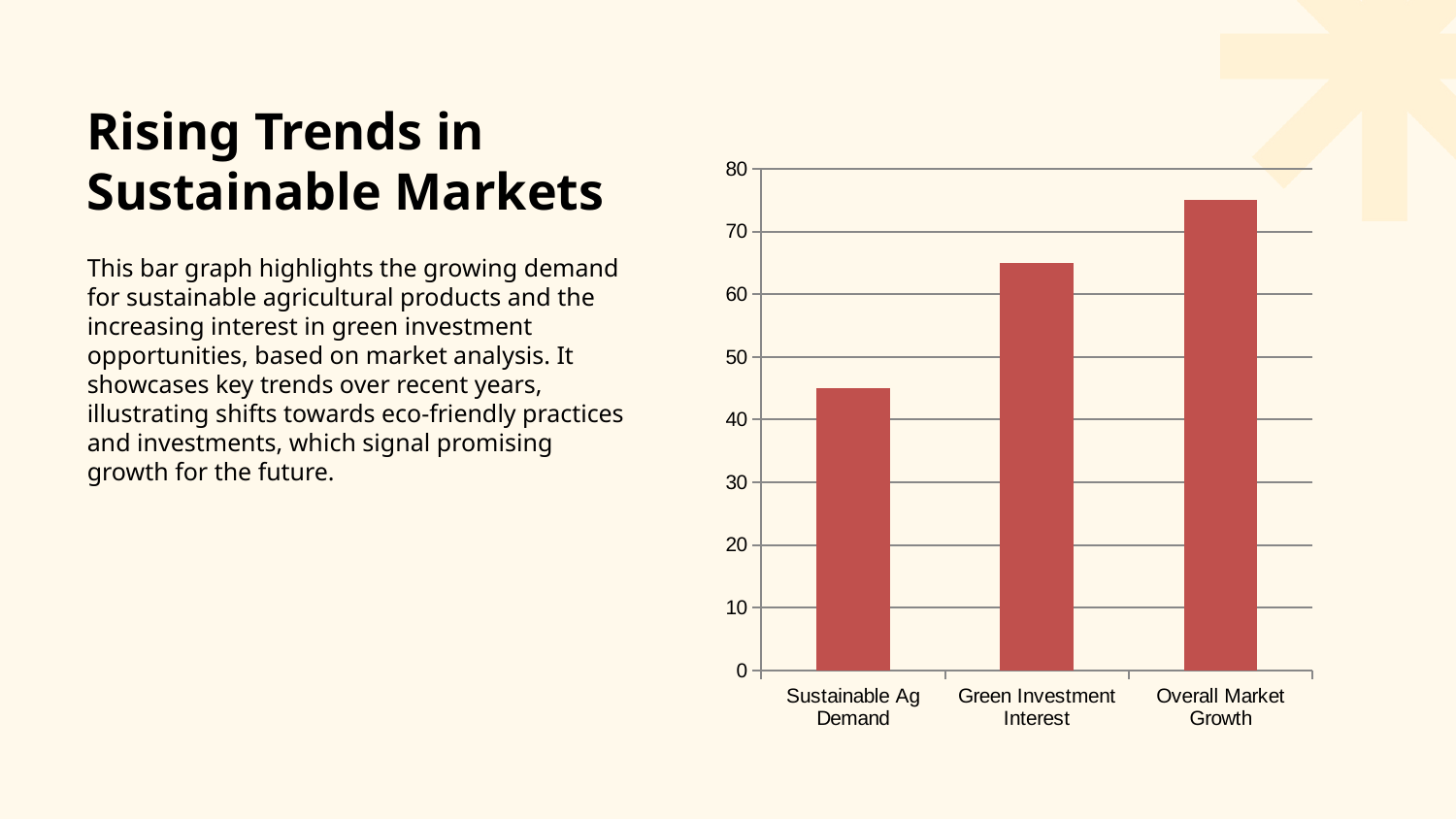
How many categories are plotted on the chart? 3 Is the value for Sustainable Ag Demand greater or less than 40? greater Which is larger, the value for Green Investment Interest or the value for Sustainable Ag Demand? Green Investment Interest Is the value for Sustainable Ag Demand greater or less than 50? less Which category has the lowest bar? Sustainable Ag Demand Is the value for Green Investment Interest greater or less than 60? greater What is the highest value shown on the vertical axis? 80 Which category has the highest bar? Overall Market Growth What kind of chart is shown on the slide? bar chart Do the bar values rise or fall from left to right across the categories? rise